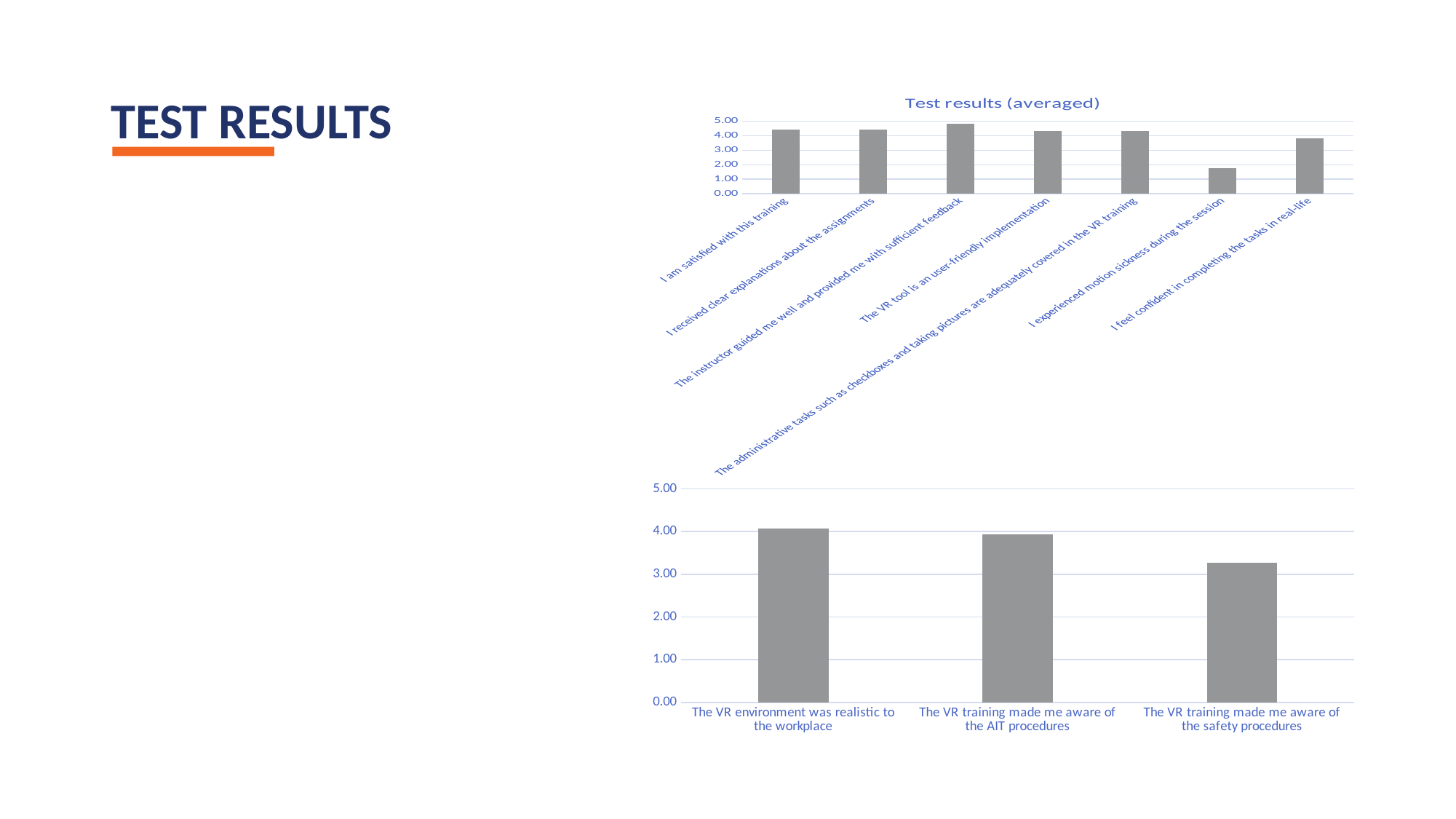
In the bottom chart, how many categories are plotted? 3 In the bottom chart, is the value for "The VR training made me aware of the safety procedures" greater or less than 3.00? greater In the top chart "Test results (averaged)", is the value for "I feel confident in completing the tasks in real-life" greater or less than 4.00? less What kind of chart is the top chart titled "Test results (averaged)"? bar chart What is the title of the top chart? Test results (averaged) In the top chart "Test results (averaged)", how many categories are plotted? 7 In the top chart "Test results (averaged)", which category has the highest value? The instructor guided me well and provided me with sufficient feedback In the top chart "Test results (averaged)", which is larger: the value for "I am satisfied with this training" or the value for "I experienced motion sickness during the session"? I am satisfied with this training In the top chart "Test results (averaged)", is the value for "I experienced motion sickness during the session" greater or less than 2.00? less In the bottom chart, which category has the lowest value? The VR training made me aware of the safety procedures In the top chart "Test results (averaged)", which category has the lowest value? I experienced motion sickness during the session